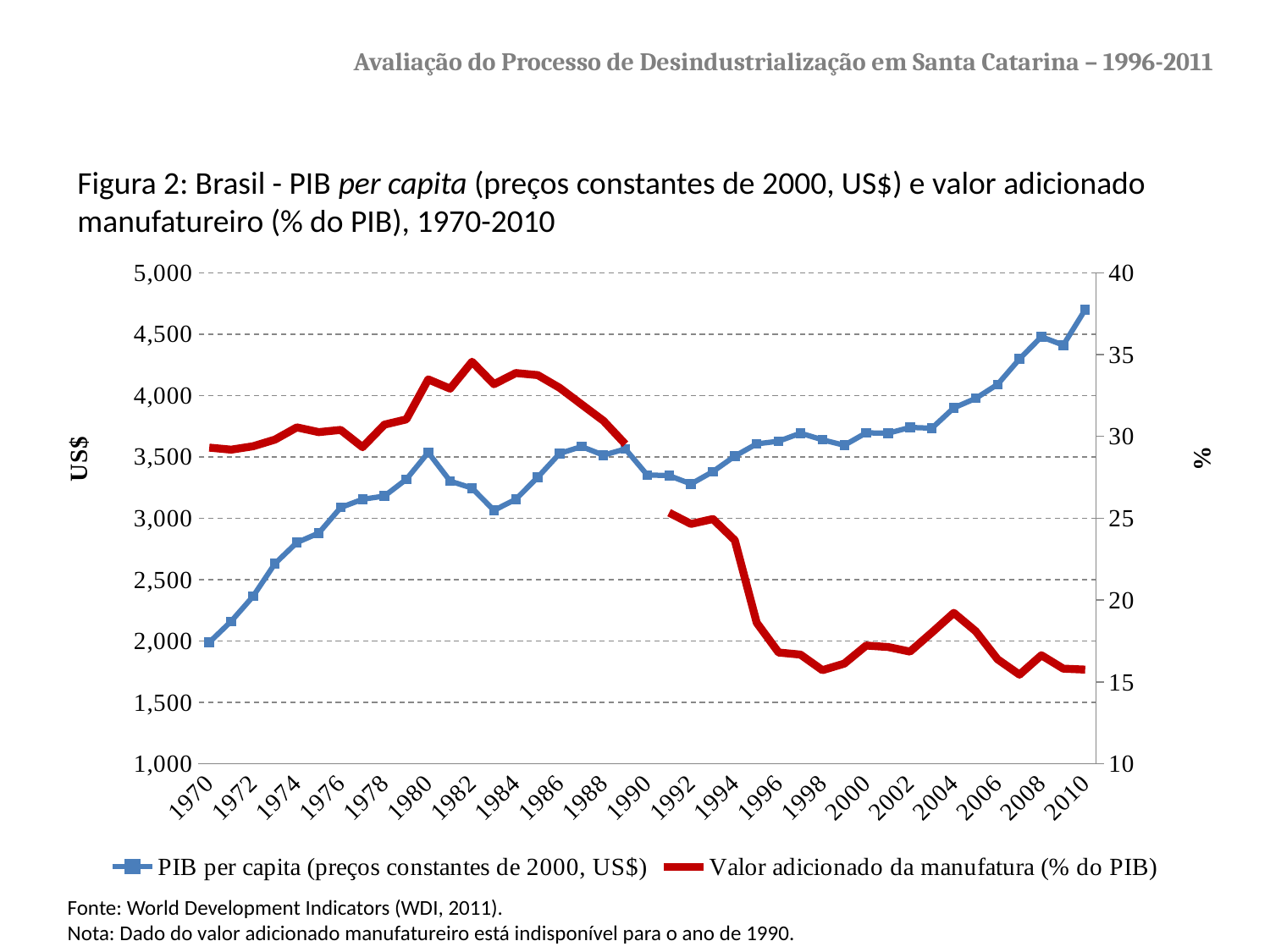
Which is larger: the Valor adicionado da manufatura (% do PIB) in 1982 or in 2010? 1982 Is the Valor adicionado da manufatura (% do PIB) value for 2010 greater or less than 20? less Is the PIB per capita value for 2010 greater or less than 4,500? greater What kind of chart is shown on the slide? line chart In which year does the Valor adicionado da manufatura (% do PIB) series reach its highest point? 1982 Does the PIB per capita series generally rise or fall from 1970 to 2010? rise Which year has the lowest PIB per capita value? 1970 What is the label of the left vertical axis? US$ How many series does the legend list? 2 Is the Valor adicionado da manufatura (% do PIB) value for 1982 greater or less than 30? greater Does the Valor adicionado da manufatura (% do PIB) series rise or fall from 1982 to 2010? fall Which year has the highest PIB per capita value? 2010